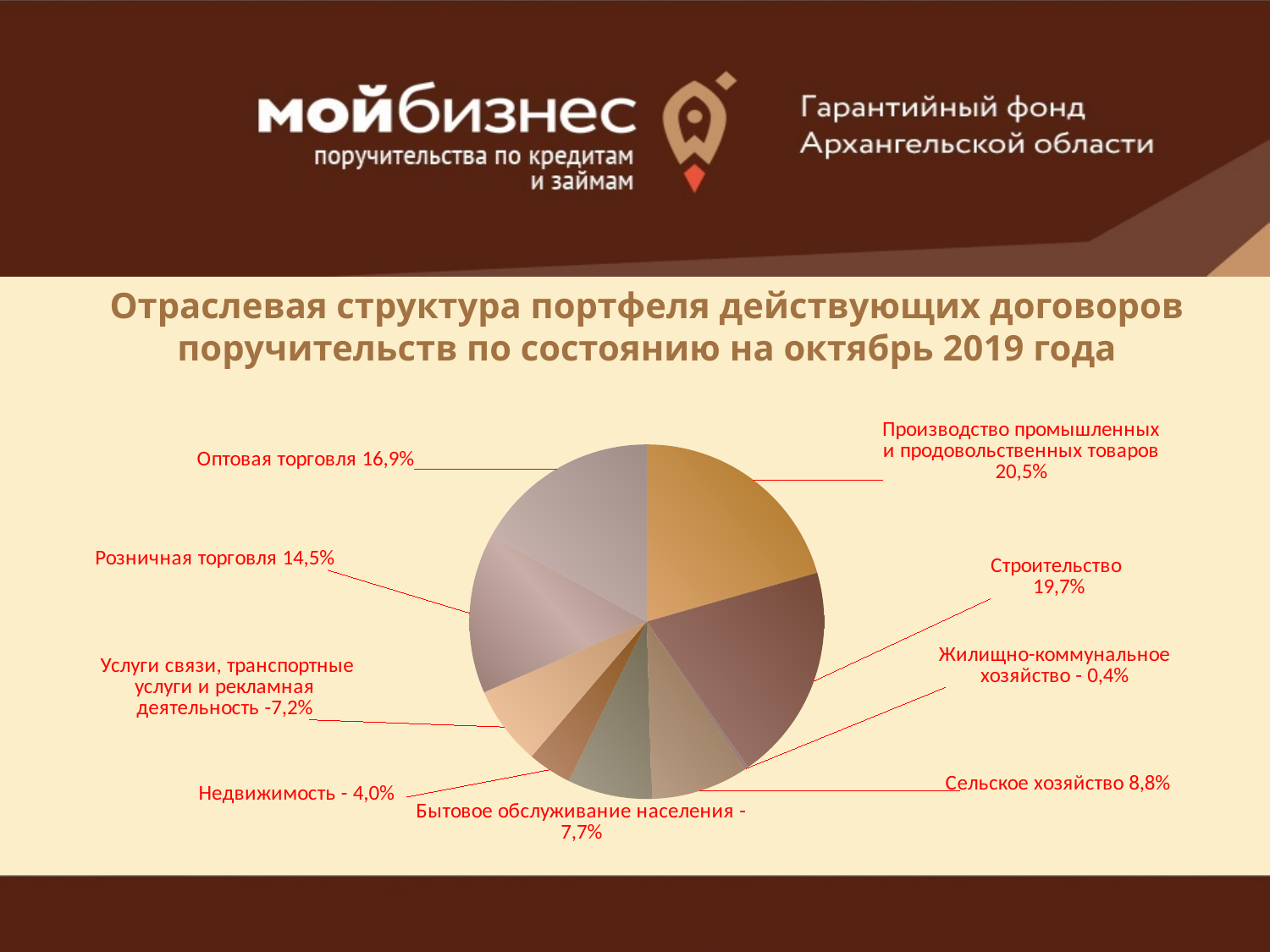
Which sector has the smallest share in the pie chart? Жилищно-коммунальное хозяйство What is the value shown for Строительство? 19,7% What type of chart is shown on the slide? Pie chart How many sectors are shown in the pie chart? 9 Which sector has the largest share in the pie chart? Производство промышленных и продовольственных товаров What is the difference between the shares of Производство промышленных и продовольственных товаров and Строительство? 0,8% What is the title of the chart on the slide? Отраслевая структура портфеля действующих договоров поручительств по состоянию на октябрь 2019 года What is the difference between the shares of Оптовая торговля and Розничная торговля? 2,4% What percentage is shown for Сельское хозяйство? 8,8% What share of the portfolio does Оптовая торговля hold? 16,9% Which is larger: the share of Недвижимость or the share of Услуги связи, транспортные услуги и рекламная деятельность? Услуги связи, транспортные услуги и рекламная деятельность What is the value for Бытовое обслуживание населения? 7,7%